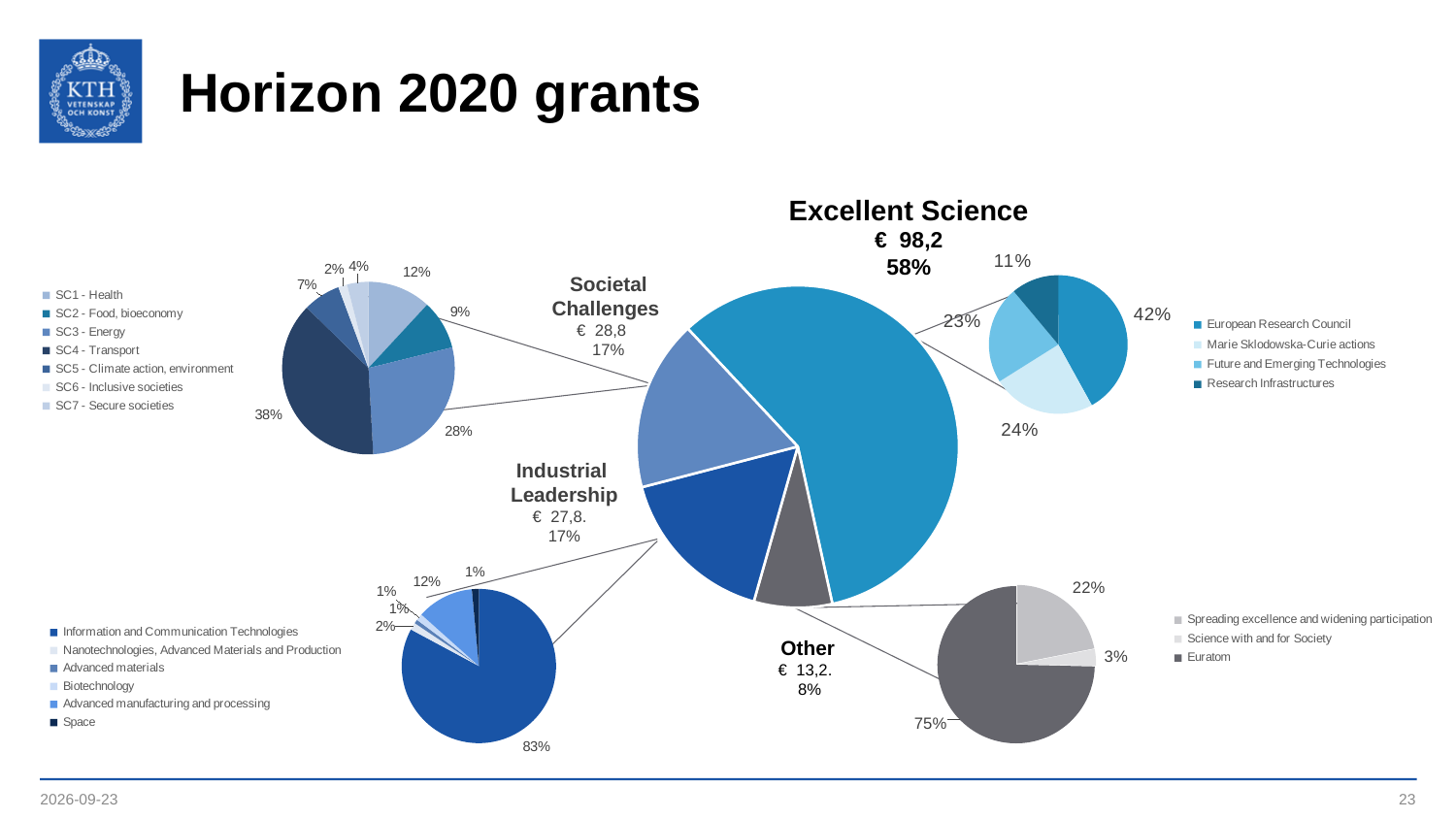
In the central pie chart, what share does Other have? 8% In the Excellent Science breakdown pie, what is the largest share shown? 42% In the central pie chart, which segment has the largest share? Excellent Science What kind of chart is used for the Horizon 2020 grants on this slide? pie chart In the central pie chart, which segment has the smallest share? Other How many entries does the legend for the Societal Challenges breakdown pie list? 7 In the Industrial Leadership breakdown pie, what is the largest share shown? 83% How many entries does the legend for the Excellent Science breakdown pie list? 4 In the central pie chart, what amount is shown for Societal Challenges? € 28,8 In the central pie chart, what is the difference in share between Excellent Science and Industrial Leadership? 41 percentage points In the central pie chart, what share does Excellent Science have? 58% How many segments does the central pie chart have? 4